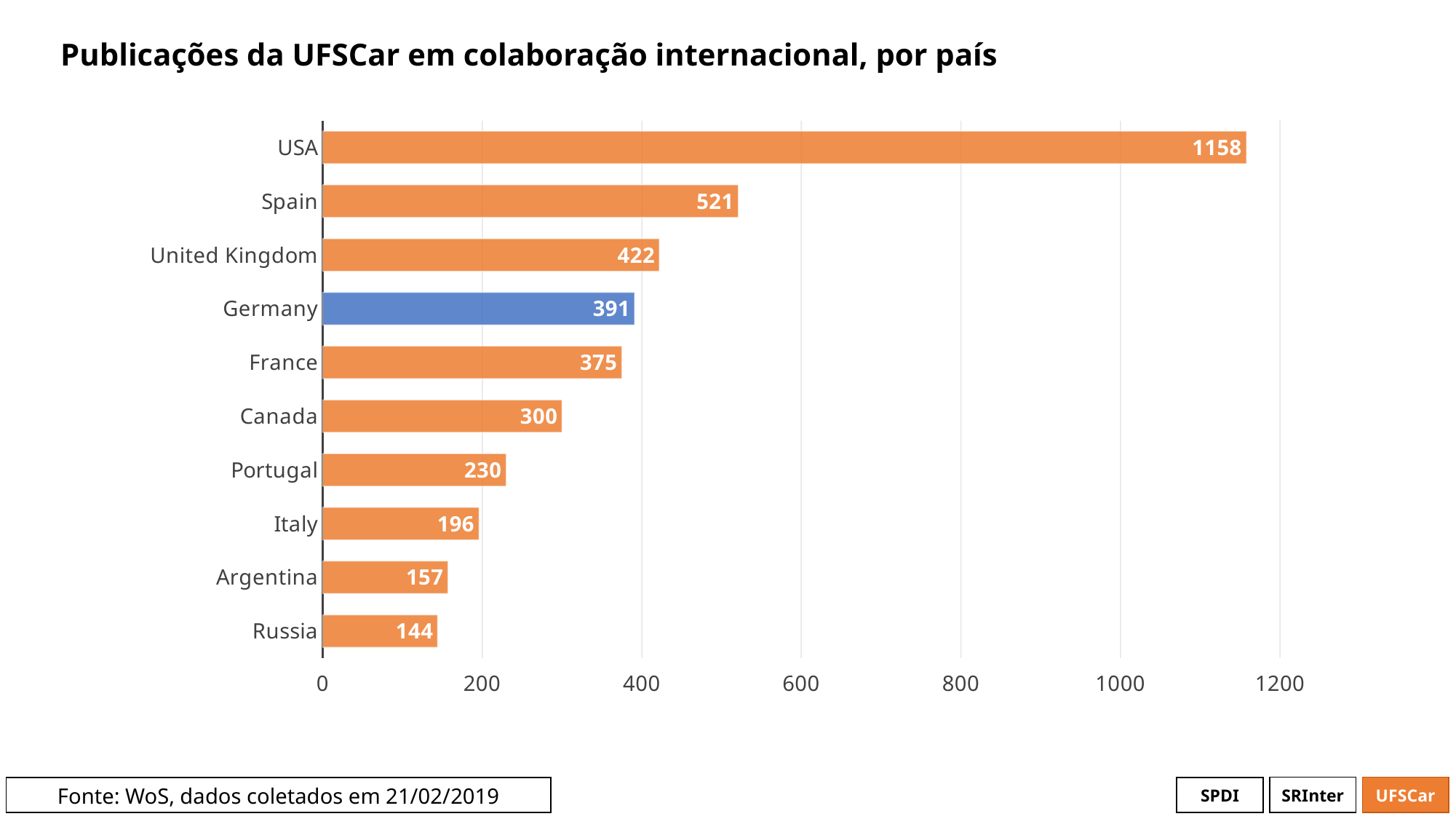
Which country's bar is coloured blue instead of orange? Germany Which country has the highest value? USA What is the value for Spain? 521 What is the difference between the values for Italy and Argentina? 39 What is the value for Germany? 391 Which country has the lowest value? Russia What is the value for Portugal? 230 How many countries are shown in the chart? 10 Is the value for Canada greater or less than 400? less Which is larger, the value for United Kingdom or the value for France? United Kingdom What kind of chart is shown on the slide? bar chart What is the difference between the values for USA and Spain? 637